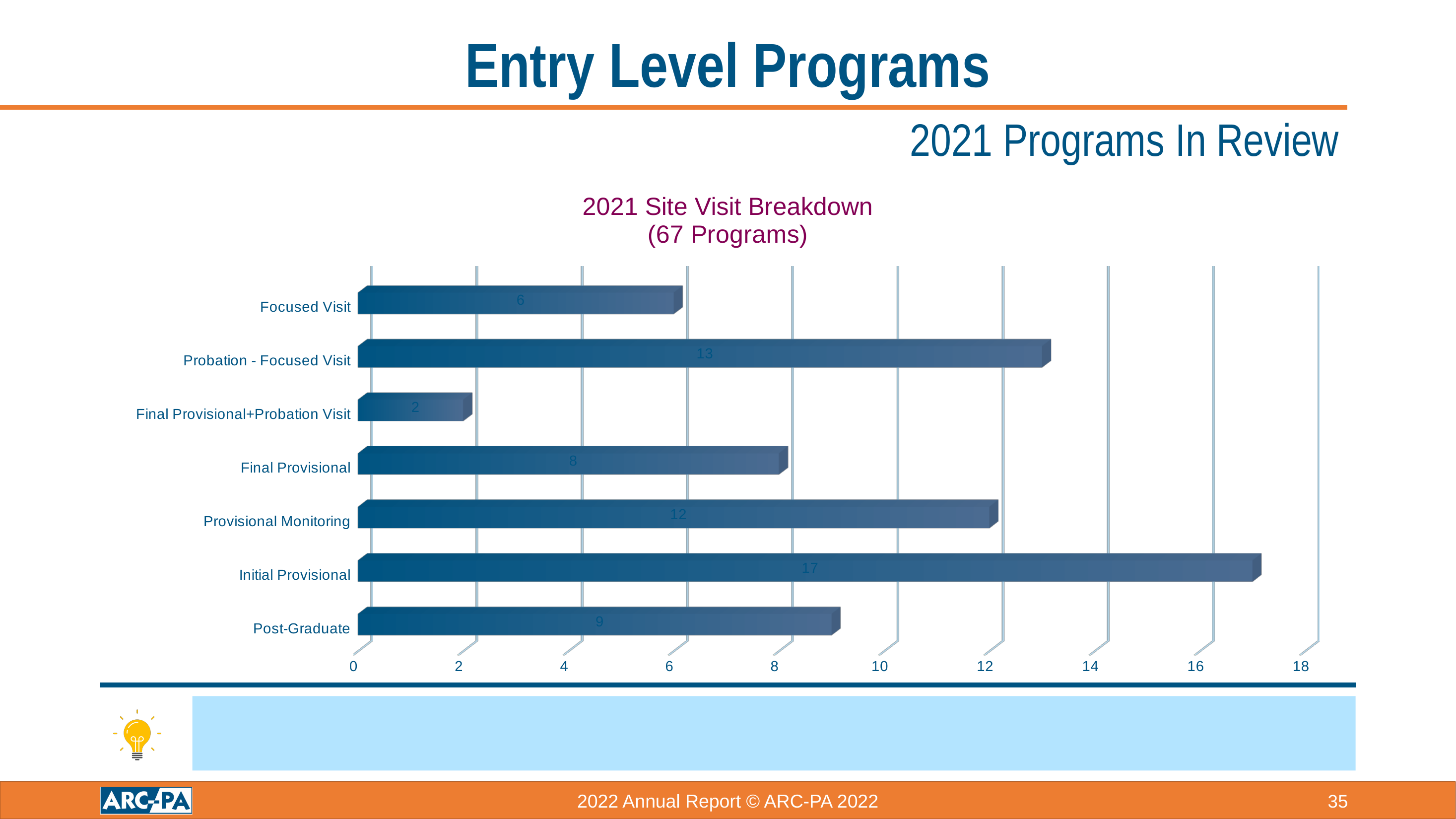
What is the value for Final Provisional+Probation Visit? 2 Is the value for Probation - Focused Visit greater or less than 10? greater What is the value for Post-Graduate? 9 What kind of chart is shown on the slide? Bar chart How many categories are shown in the chart? 7 Which category has the lowest value? Final Provisional+Probation Visit Which category has the highest value? Initial Provisional Which is larger, the value for Focused Visit or the value for Final Provisional? Final Provisional What is the title of the chart? 2021 Site Visit Breakdown (67 Programs) What is the value for Initial Provisional? 17 What is the value for Probation - Focused Visit? 13 What is the difference between the values for Initial Provisional and Provisional Monitoring? 5